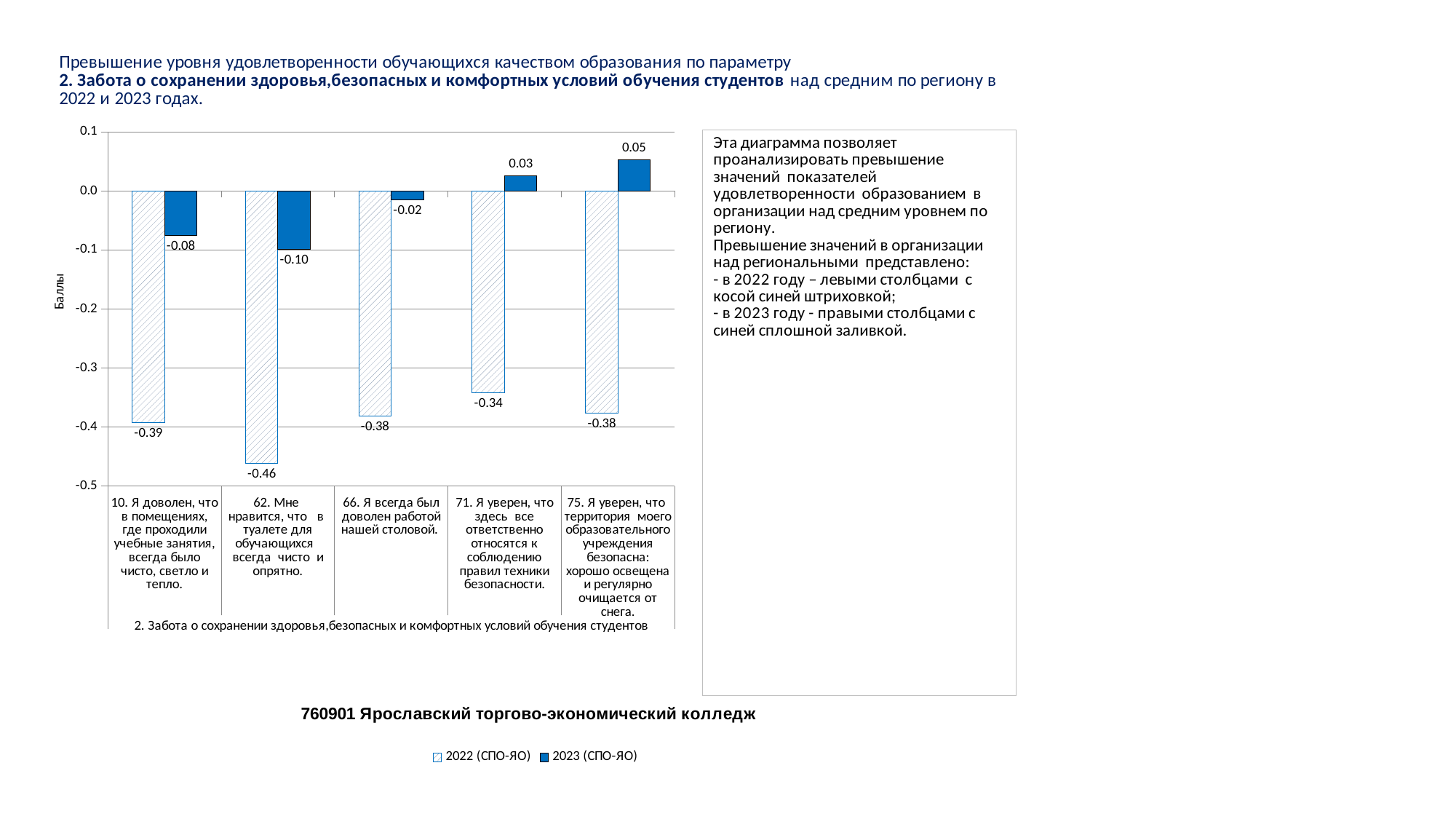
Is the 2022 (СПО-ЯО) value for category 10 greater or less than -0.3? less How many categories are shown on the x axis of the chart? 5 How many series does the chart legend list? 2 What is the 2023 (СПО-ЯО) value for category 75 ("Я уверен, что территория моего образовательного учреждения безопасна")? 0.05 Which category has the highest 2023 (СПО-ЯО) value? 75. Я уверен, что территория моего образовательного учреждения безопасна Which is larger for category 10: the 2022 (СПО-ЯО) value or the 2023 (СПО-ЯО) value? 2023 (СПО-ЯО) What is the difference between the 2023 and 2022 values for category 71 ("Я уверен, что здесь все ответственно относятся к соблюдению правил техники безопасности")? 0.37 What is the 2023 (СПО-ЯО) value for category 66 ("Я всегда был доволен работой нашей столовой")? -0.02 What type of chart is shown on the slide? bar chart What is the label of the vertical axis of the chart? Баллы Which category has the lowest 2022 (СПО-ЯО) value? 62. Мне нравится, что в туалете для обучающихся всегда чисто и опрятно. What is the 2022 (СПО-ЯО) value for category 62 ("Мне нравится, что в туалете для обучающихся всегда чисто и опрятно")? -0.46